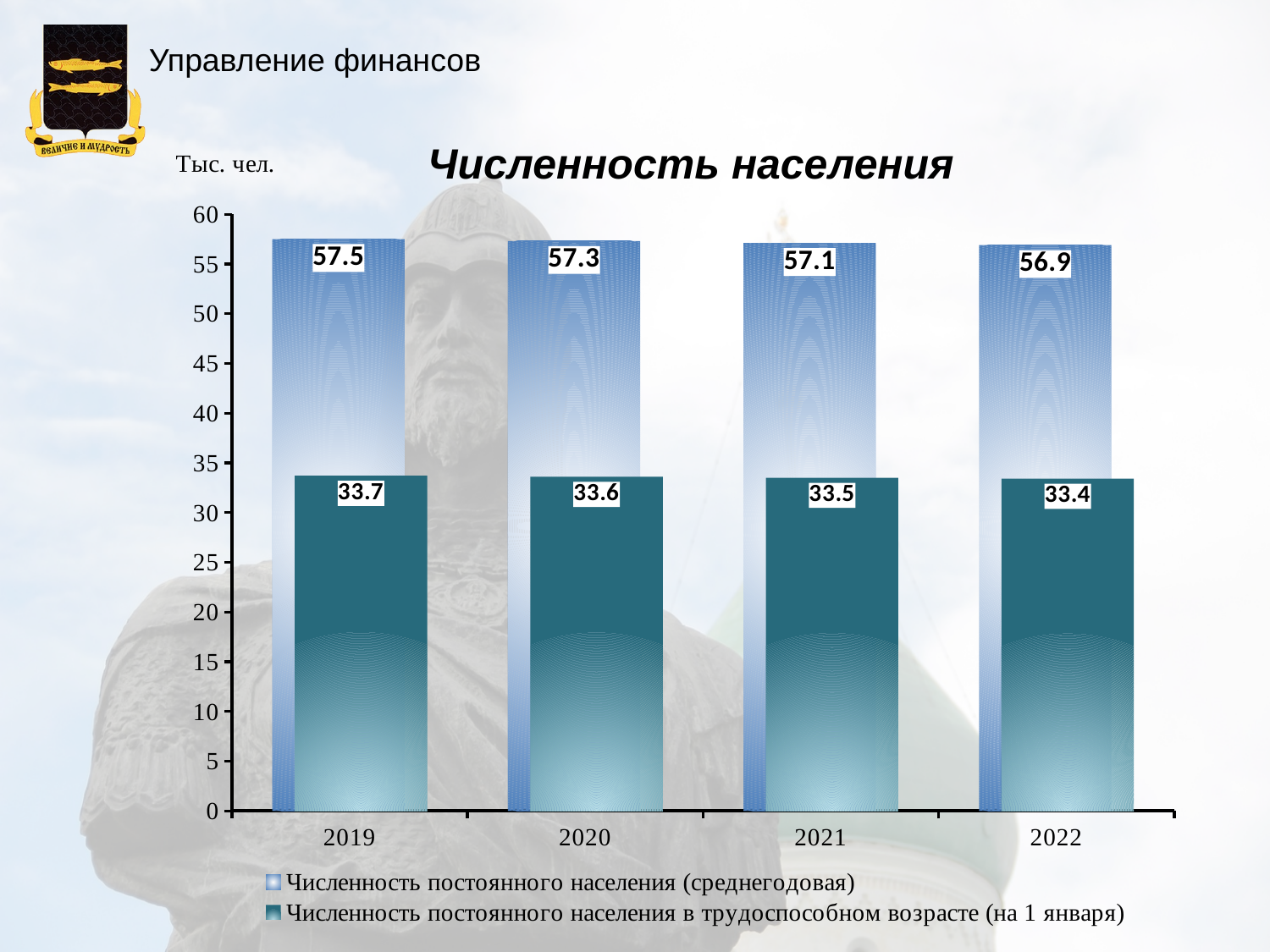
Which is larger: 'Численность постоянного населения в трудоспособном возрасте (на 1 января)' in 2019 or in 2021? 2019 What kind of chart is shown on the slide? bar chart How many series does the legend list? 2 Which year has the highest value for 'Численность постоянного населения (среднегодовая)'? 2019 Which year has the lowest value for 'Численность постоянного населения в трудоспособном возрасте (на 1 января)'? 2022 What is the value of 'Численность постоянного населения (среднегодовая)' for 2019? 57.5 What is the difference between 'Численность постоянного населения (среднегодовая)' and 'Численность постоянного населения в трудоспособном возрасте (на 1 января)' in 2020? 23.7 Do the values for 'Численность постоянного населения (среднегодовая)' rise or fall from 2019 to 2022? fall What is the value of 'Численность постоянного населения в трудоспособном возрасте (на 1 января)' for 2022? 33.4 What is the value of 'Численность постоянного населения (среднегодовая)' for 2021? 57.1 How many years are shown on the x axis? 4 By how much did 'Численность постоянного населения (среднегодовая)' change from 2019 to 2022? 0.6